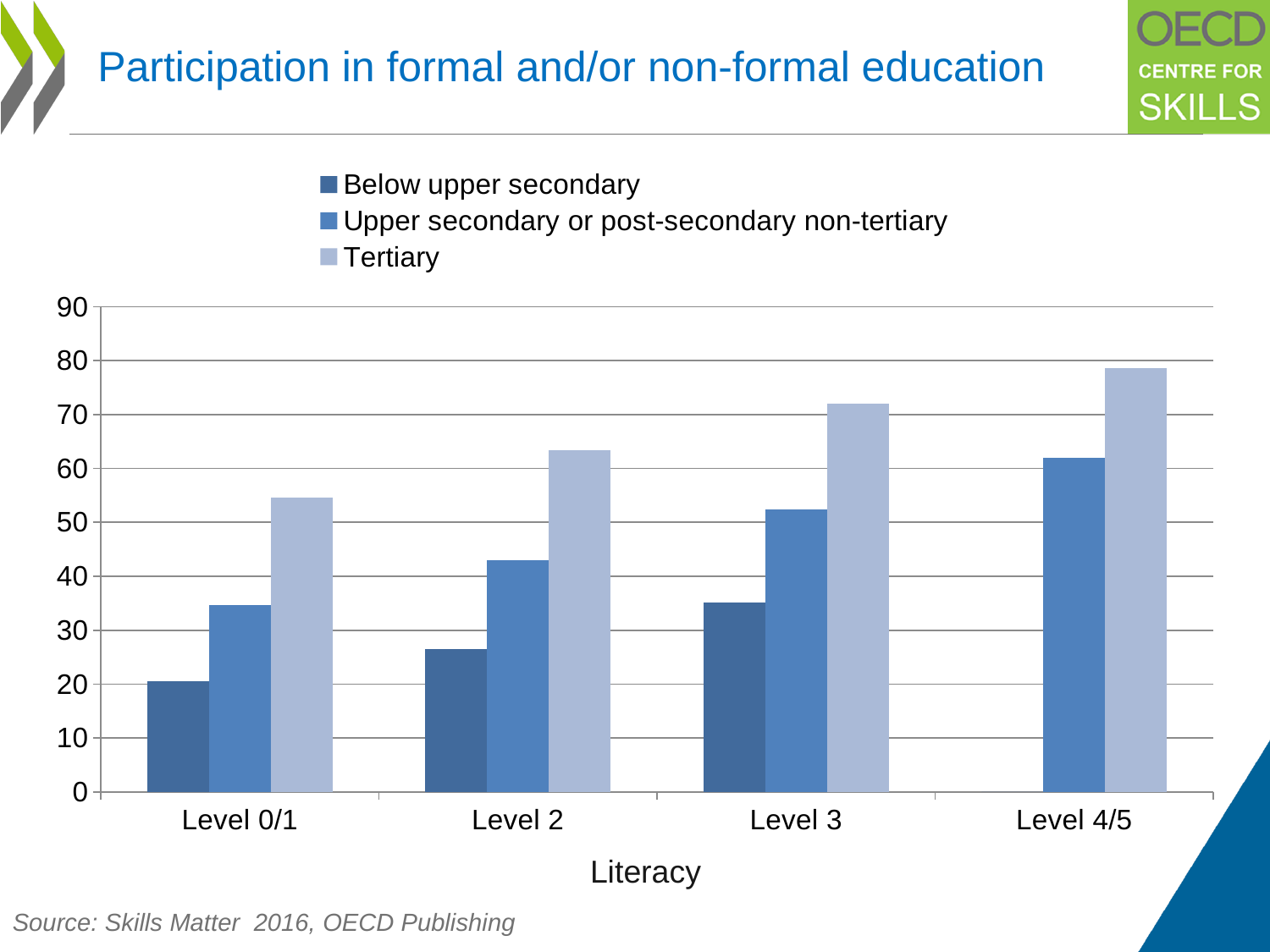
Do the Tertiary values rise or fall as literacy level increases from Level 0/1 to Level 4/5? rise What kind of chart is shown on the slide? Bar chart Is the Tertiary value for Level 0/1 greater or less than 50? greater Which literacy level has the highest Tertiary bar? Level 4/5 Which is larger: the Upper secondary or post-secondary non-tertiary value for Level 2 or the Below upper secondary value for Level 3? Upper secondary or post-secondary non-tertiary for Level 2 How many series does the legend list? 3 How many literacy level categories are shown on the x axis? 4 Is the Upper secondary or post-secondary non-tertiary value for Level 3 greater or less than 40? greater Is the Below upper secondary value for Level 0/1 greater or less than 30? less What is the label of the x axis? Literacy